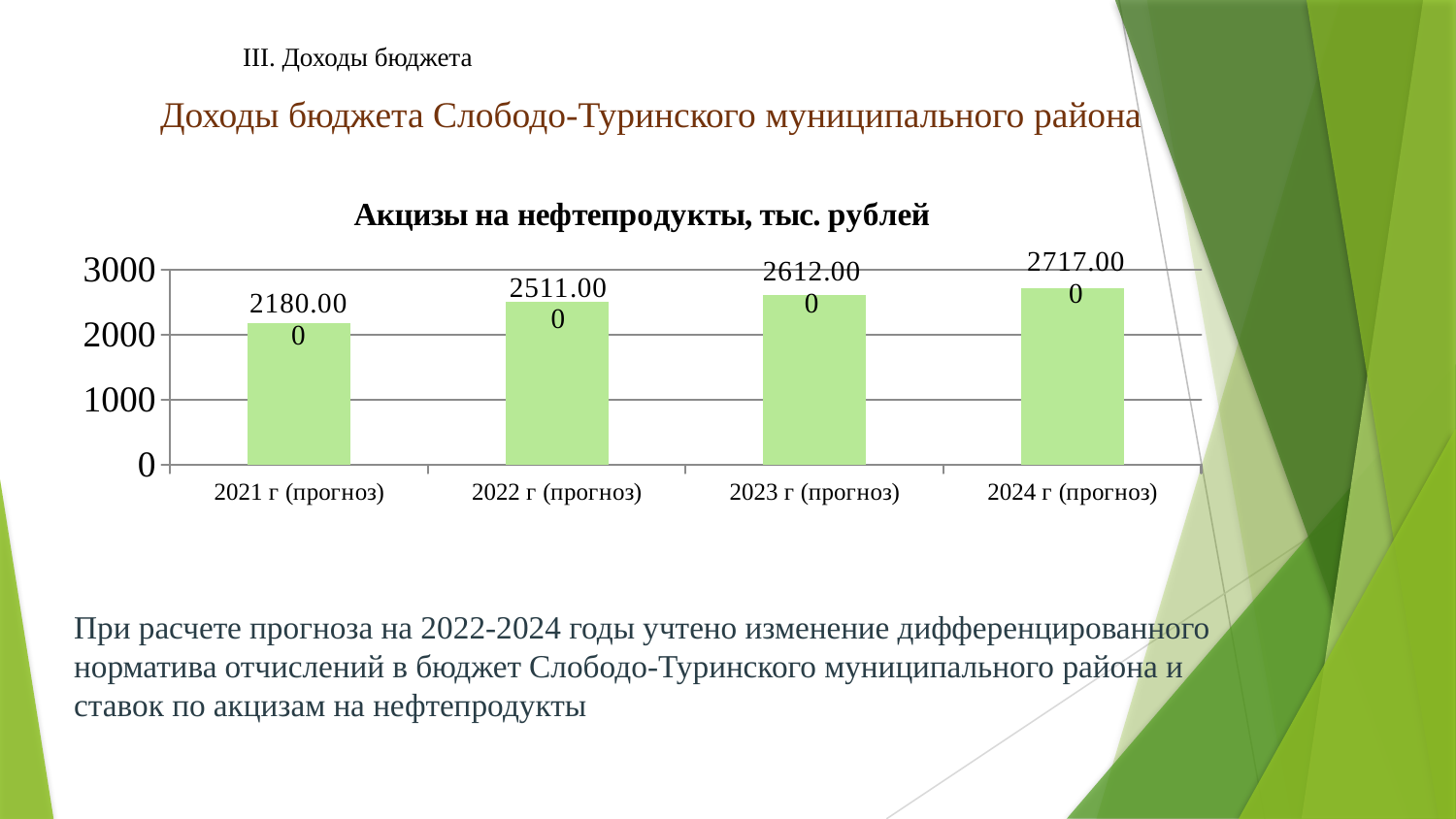
Is the value for 2021 г (прогноз) greater or less than 2000? greater What is the value for 2022 г (прогноз) in the chart? 2511.00 What kind of chart is shown on the slide? bar chart Which is larger, the value for 2022 г (прогноз) or the value for 2023 г (прогноз)? 2023 г (прогноз) Which category has the lowest value in the chart? 2021 г (прогноз) What is the value for 2021 г (прогноз) in the chart? 2180.00 What is the value for 2024 г (прогноз) in the chart? 2717.00 What is the value for 2023 г (прогноз) in the chart? 2612.00 How many categories are shown on the x axis of the chart? 4 Do the values rise or fall from 2021 г (прогноз) to 2024 г (прогноз)? rise What is the difference between the values for 2024 г (прогноз) and 2021 г (прогноз)? 537.00 Which category has the highest value in the chart? 2024 г (прогноз)